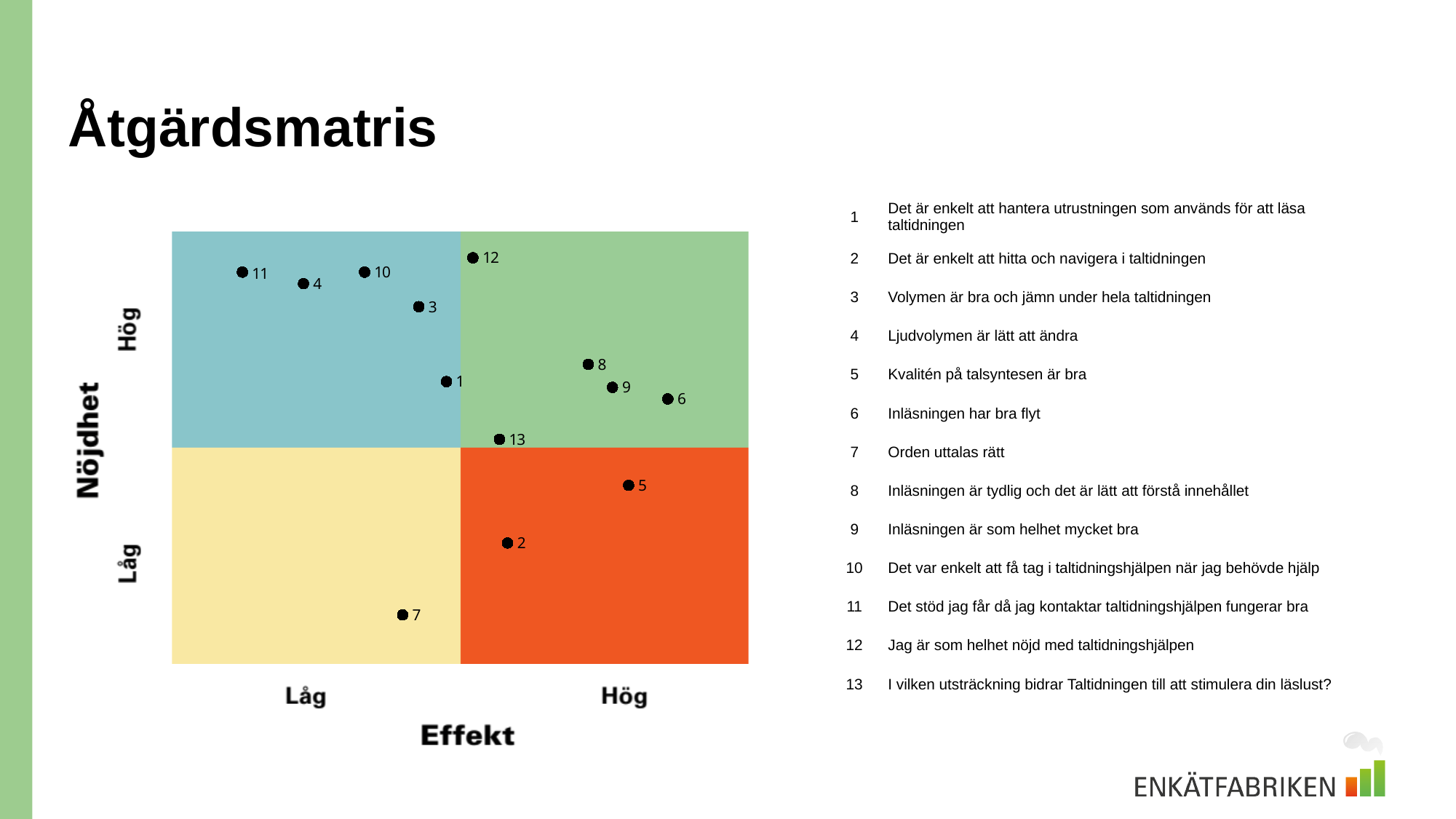
Which point has the highest Nöjdhet (is plotted highest) in the matrix? 12 How many points lie in the yellow (low Nöjdhet, low Effekt) quadrant? 1 How many points lie in the orange (low Nöjdhet, high Effekt) quadrant? 2 What kind of chart is shown on the slide? scatter chart What is the label of the vertical axis of the matrix? Nöjdhet Which point has the highest Effekt (is plotted furthest right) in the matrix? 6 Which point has the lowest Nöjdhet (is plotted lowest) in the matrix? 7 What is the label of the horizontal axis of the matrix? Effekt Which point has the lowest Effekt (is plotted furthest left) in the matrix? 11 How many data points are plotted in the matrix? 13 Which point has higher Effekt, point 9 or point 3? 9 Which point has higher Nöjdhet, point 5 or point 2? 5